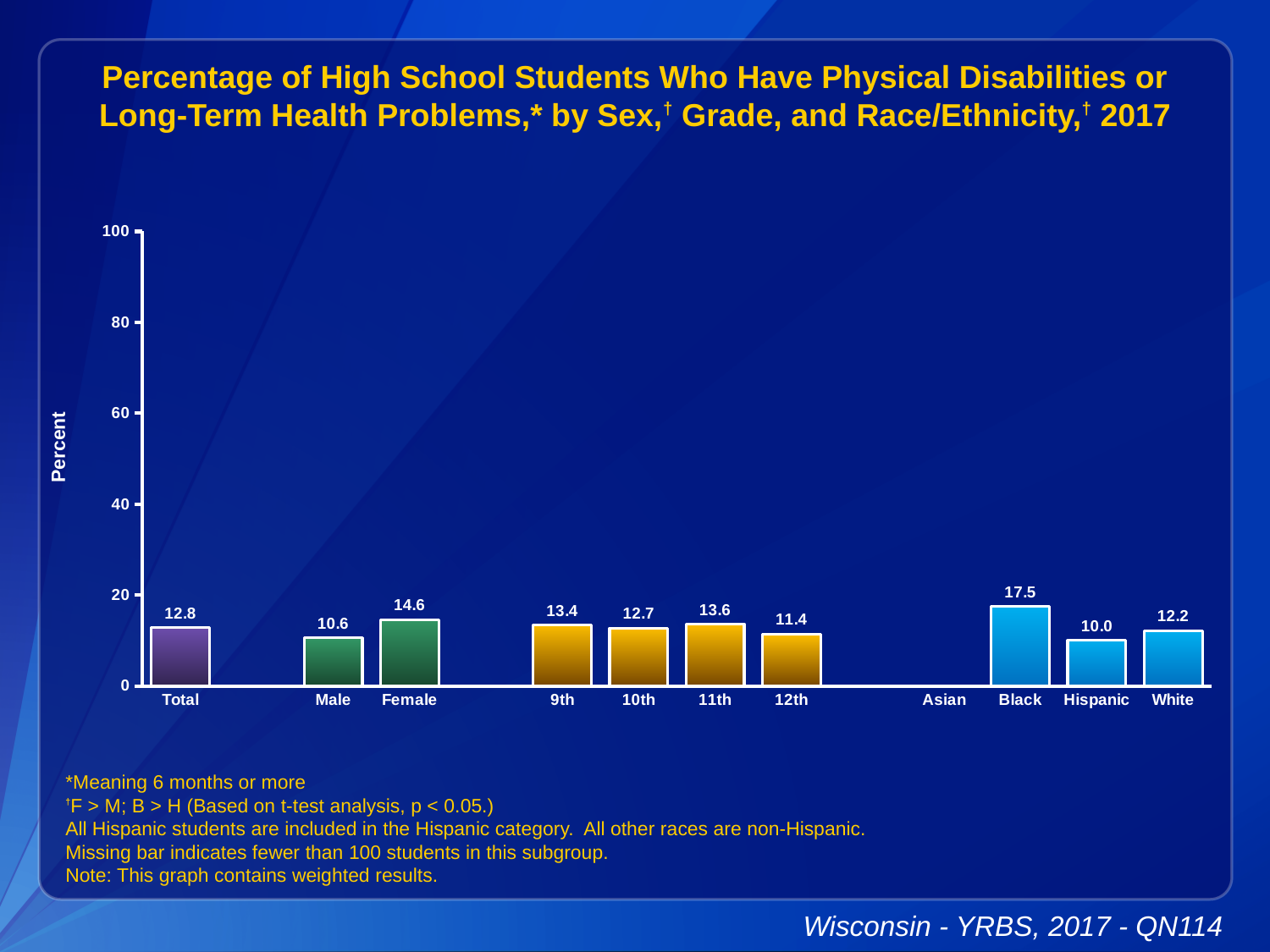
Which category has the lowest value among the bars shown? Hispanic What is the value for 12th grade? 11.4 How many bars are plotted on the chart? 11 What is the value for Female? 14.6 Which category has the highest value? Black Which race/ethnicity category has no bar shown? Asian What kind of chart is shown? bar chart What is the value for Total? 12.8 Is the value for Black greater or less than 20? less What is the label on the y axis? Percent Which is larger, the value for 9th grade or the value for 10th grade? 9th What is the difference between the Female and Male values? 4.0